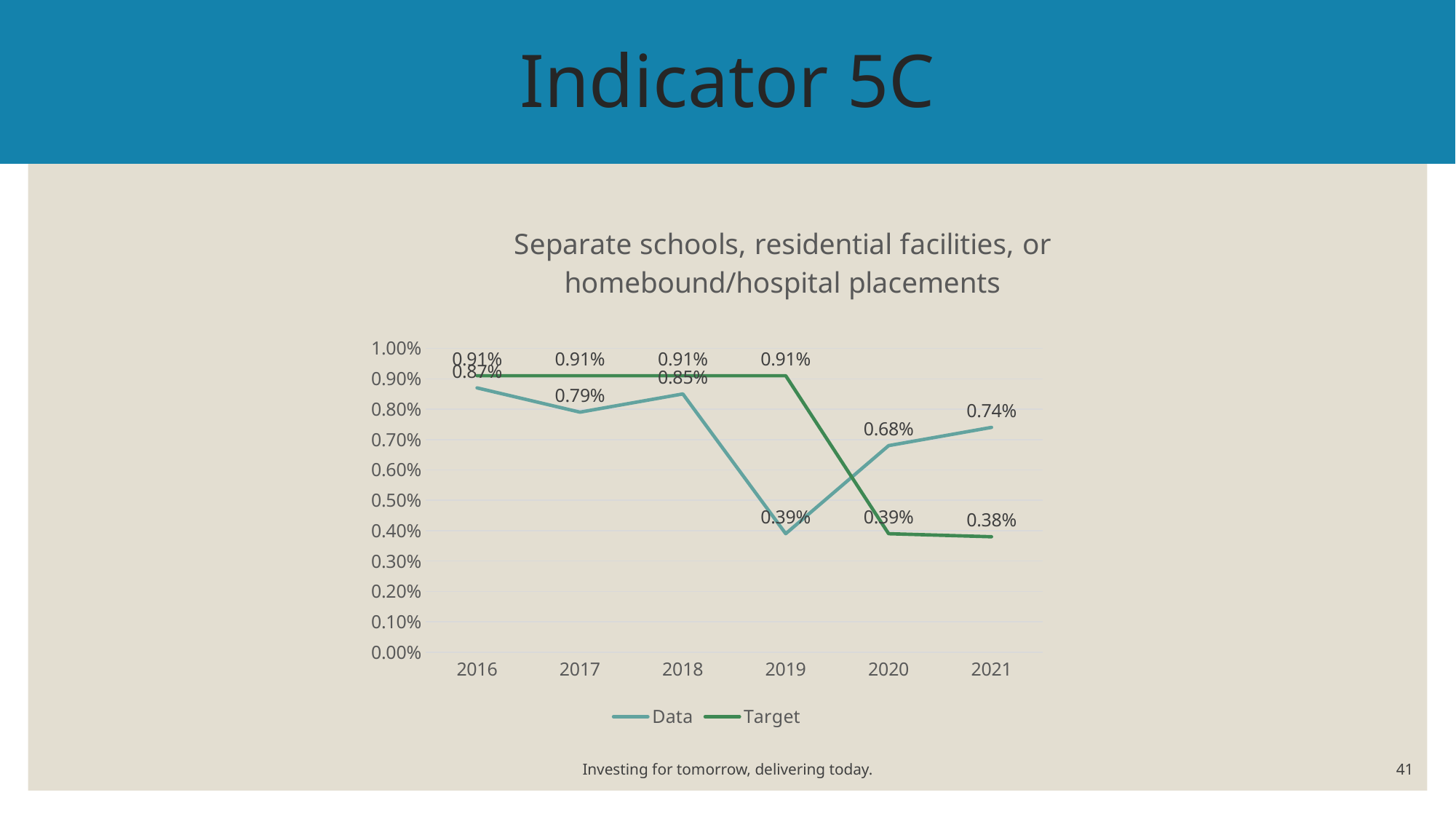
What is the Data value for 2017? 0.79% What type of chart is shown on the slide? line chart What is the title of the chart? Separate schools, residential facilities, or homebound/hospital placements Which is larger in 2020, the Data value or the Target value? Data What is the Target value for 2021? 0.38% How many years are shown on the x axis? 6 What is the Data value for 2019? 0.39% In which year is the Data series at its lowest? 2019 How many series does the legend list? 2 In which year is the Data series at its highest? 2016 What is the difference between the Target and Data values in 2019? 0.52% Does the Target series rise or fall from 2019 to 2021? fall